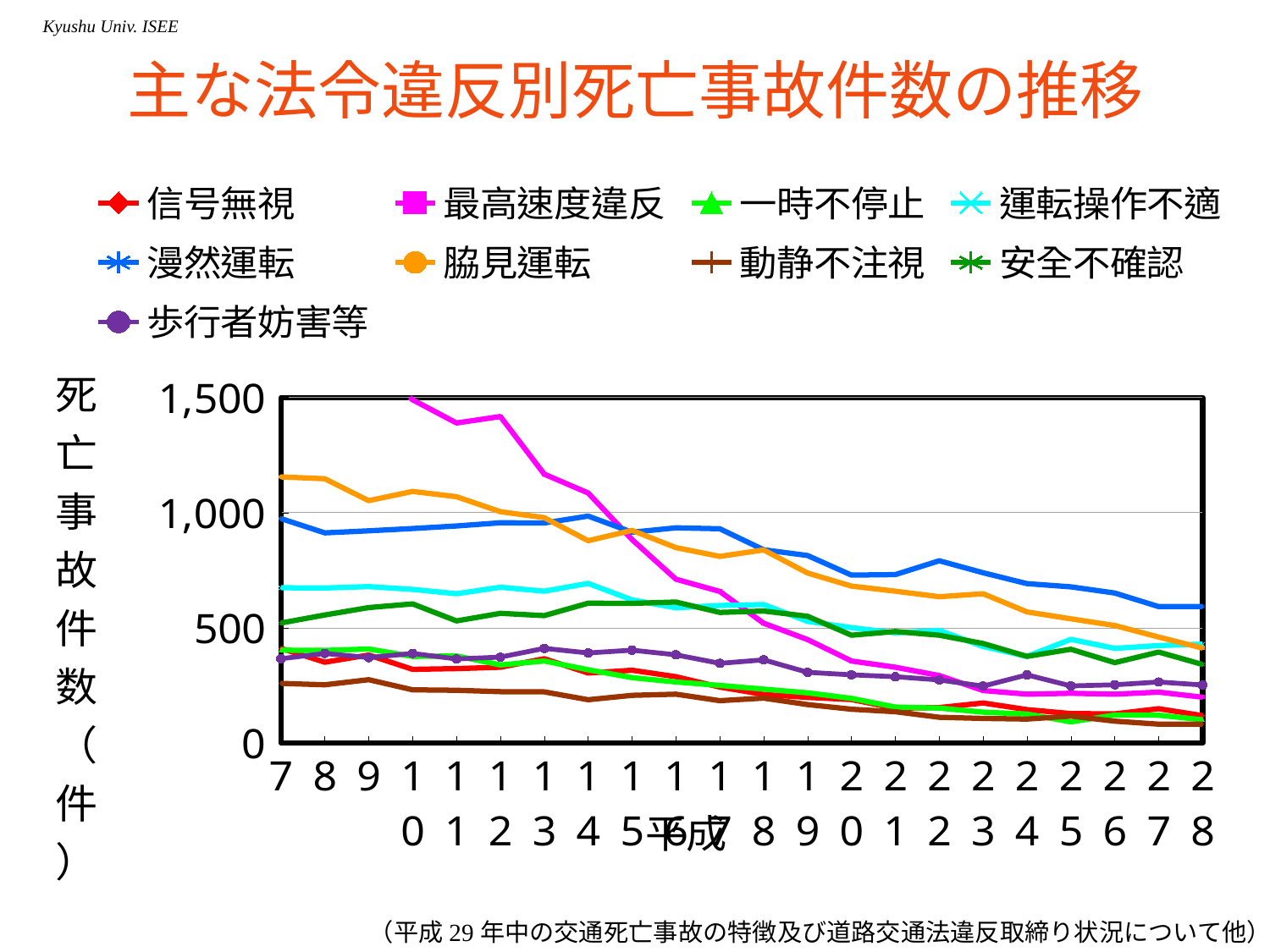
Does the value for 最高速度違反 rise or fall from 平成10 to 平成28? fall What is the label of the vertical axis? 死亡事故件数（件） How many years (x-axis points) are plotted, from 平成7 to 平成28? 22 How many series does the legend list? 9 Which series has the lowest value in 平成7? 動静不注視 Is the value for 漫然運転 in 平成28 greater or less than 500? greater Is the value for 脇見運転 in 平成7 greater or less than 1,000? greater What kind of chart is shown on the slide? line chart Is the value for 信号無視 in 平成28 greater or less than 500? less Which series has the highest value in 平成28? 漫然運転 What is the title of the chart? 主な法令違反別死亡事故件数の推移